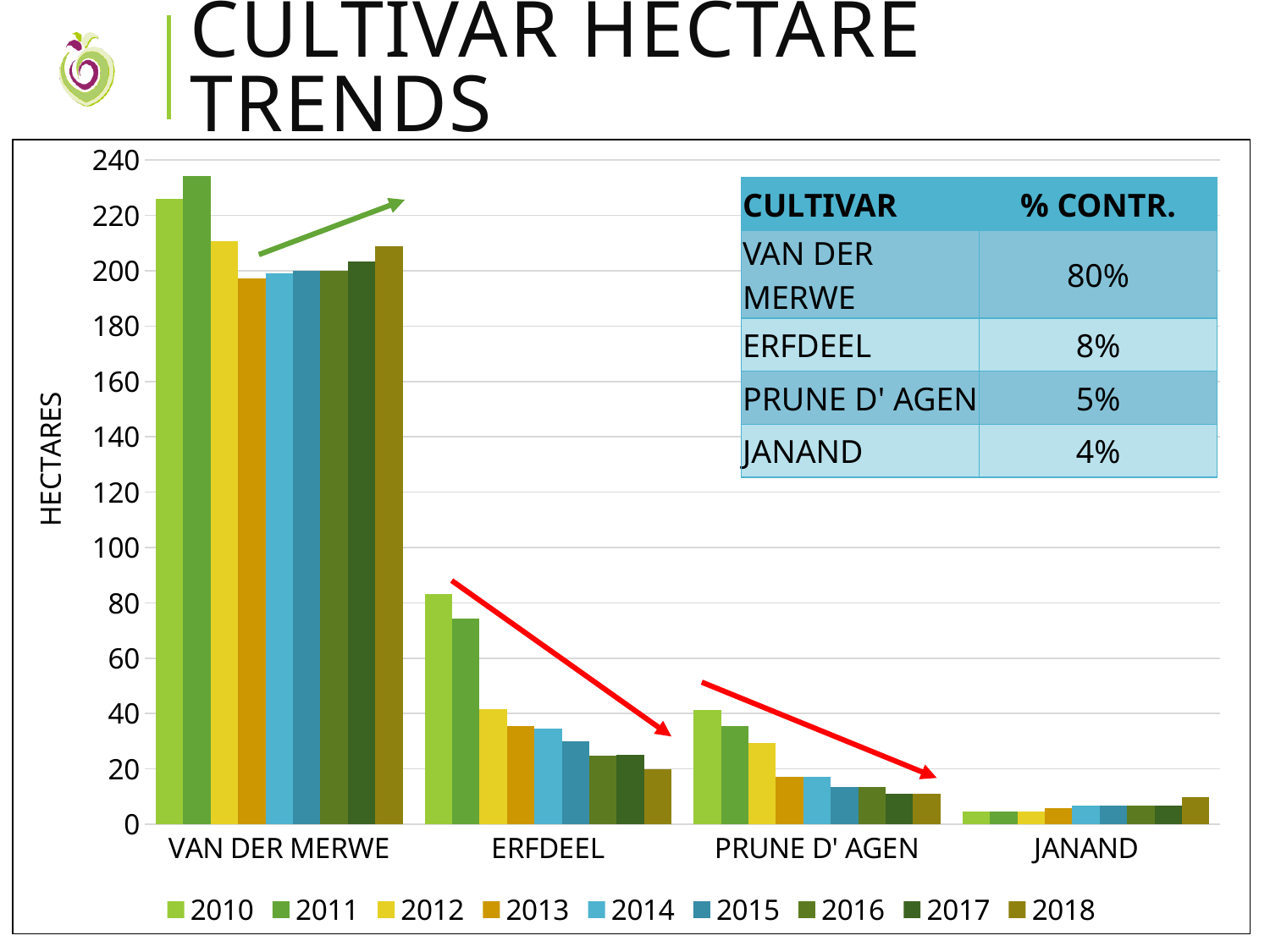
Which cultivar has the highest hectares in 2010? VAN DER MERWE How many cultivars are shown on the x axis? 4 What kind of chart is shown on the slide? bar chart How many series does the legend list? 9 Is the value for PRUNE D' AGEN in 2012 greater or less than 20? greater Is the value for ERFDEEL in 2010 greater or less than 80? greater Is the value for ERFDEEL in 2013 greater or less than 40? less What is the title of the vertical axis? HECTARES Do the hectares for ERFDEEL rise or fall from 2010 to 2018? fall Which cultivar has the lowest hectares in 2018? JANAND For VAN DER MERWE, which year has the larger value, 2010 or 2011? 2011